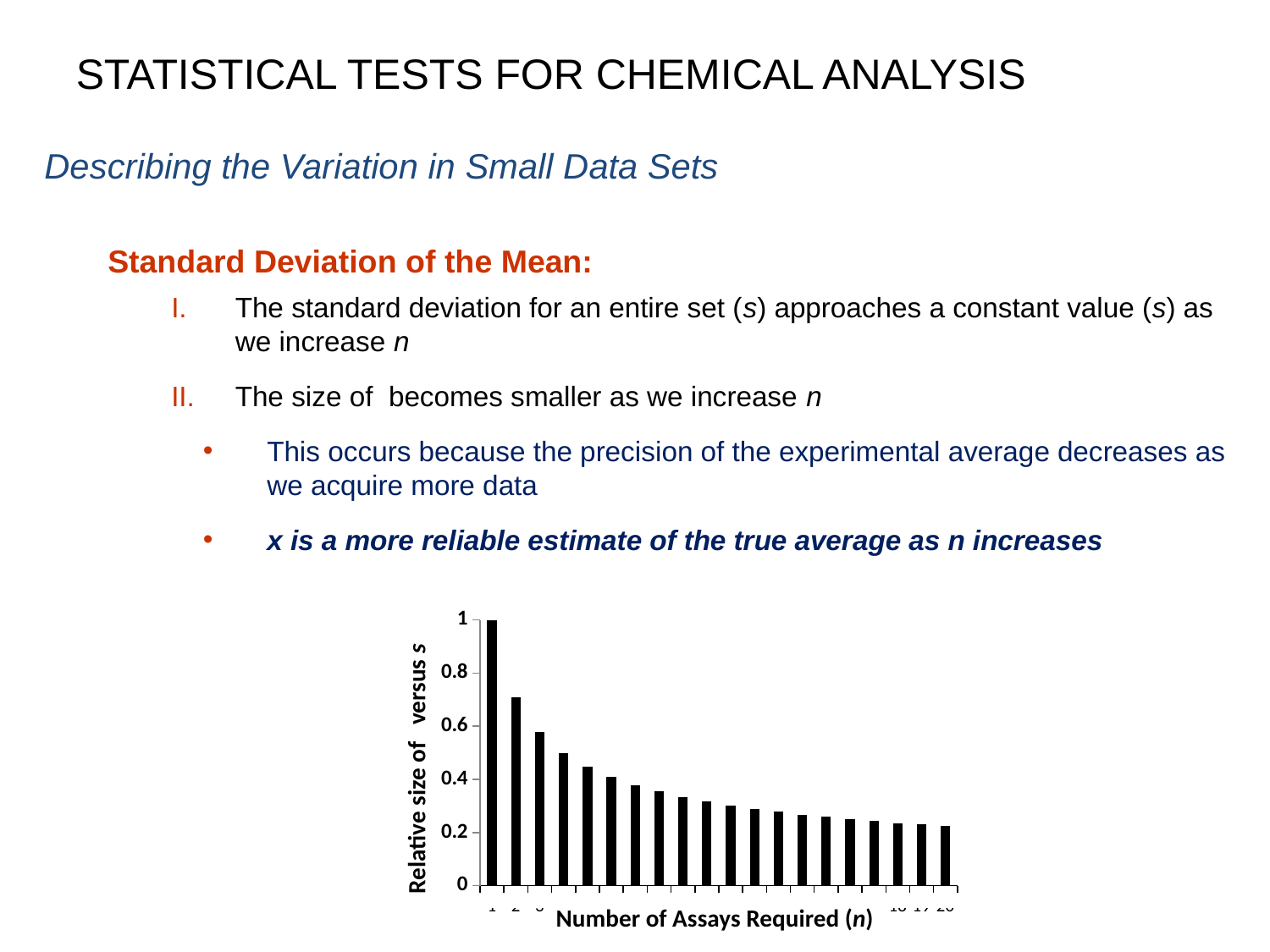
What is the relative size value for n = 1? 1 What kind of chart is shown on the slide? bar chart What colour are the bars in the chart? black Is the value for n = 10 greater or less than 0.4? less Is the value for n = 2 greater or less than 0.6? greater Which has the larger value, n = 2 or n = 3? n = 2 What is the title of the x axis of the chart? Number of Assays Required (n) Is the value for n = 3 greater or less than 0.4? greater Do the bar values rise or fall as the number of assays required (n) increases? fall How many bars are plotted in the chart? 20 Which number of assays (n) has the tallest bar? 1